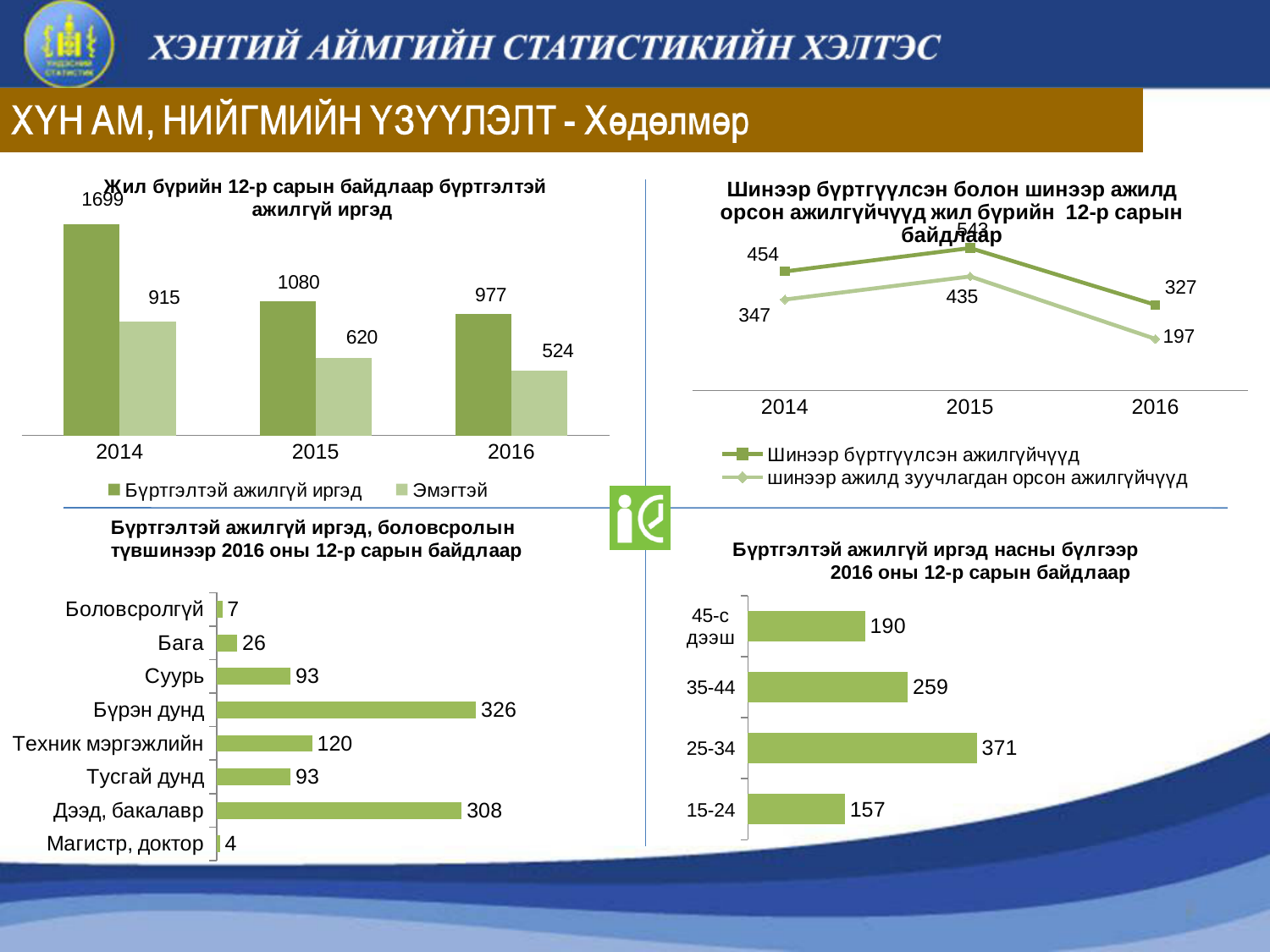
In the top-left chart, do the values of Бүртгэлтэй ажилгүй иргэд rise or fall from 2014 to 2016? fall How many categories are shown in the bottom-left chart (by education level)? 8 In the bottom-right chart (by age group), what is the value for 25-34? 371 In the top-left chart, what is the difference between Бүртгэлтэй ажилгүй иргэд and Эмэгтэй in 2015? 460 In the top-right line chart, what is the value of шинээр ажилд зуучлагдан орсон ажилгүйчүүд for 2016? 197 In the bottom-left chart (by education level), which category has the highest value? Бүрэн дунд In the top-left chart, what is the value of Бүртгэлтэй ажилгүй иргэд for 2014? 1699 In the top-right line chart, which year has the lowest value for Шинээр бүртгүүлсэн ажилгүйчүүд? 2016 In the bottom-left chart (by education level), what is the value for Техник мэргэжлийн? 120 In the top-left chart, what is the value of Эмэгтэй for 2016? 524 In the top-right line chart, what is the value of Шинээр бүртгүүлсэн ажилгүйчүүд for 2015? 543 How many series does the legend of the top-right line chart list? 2